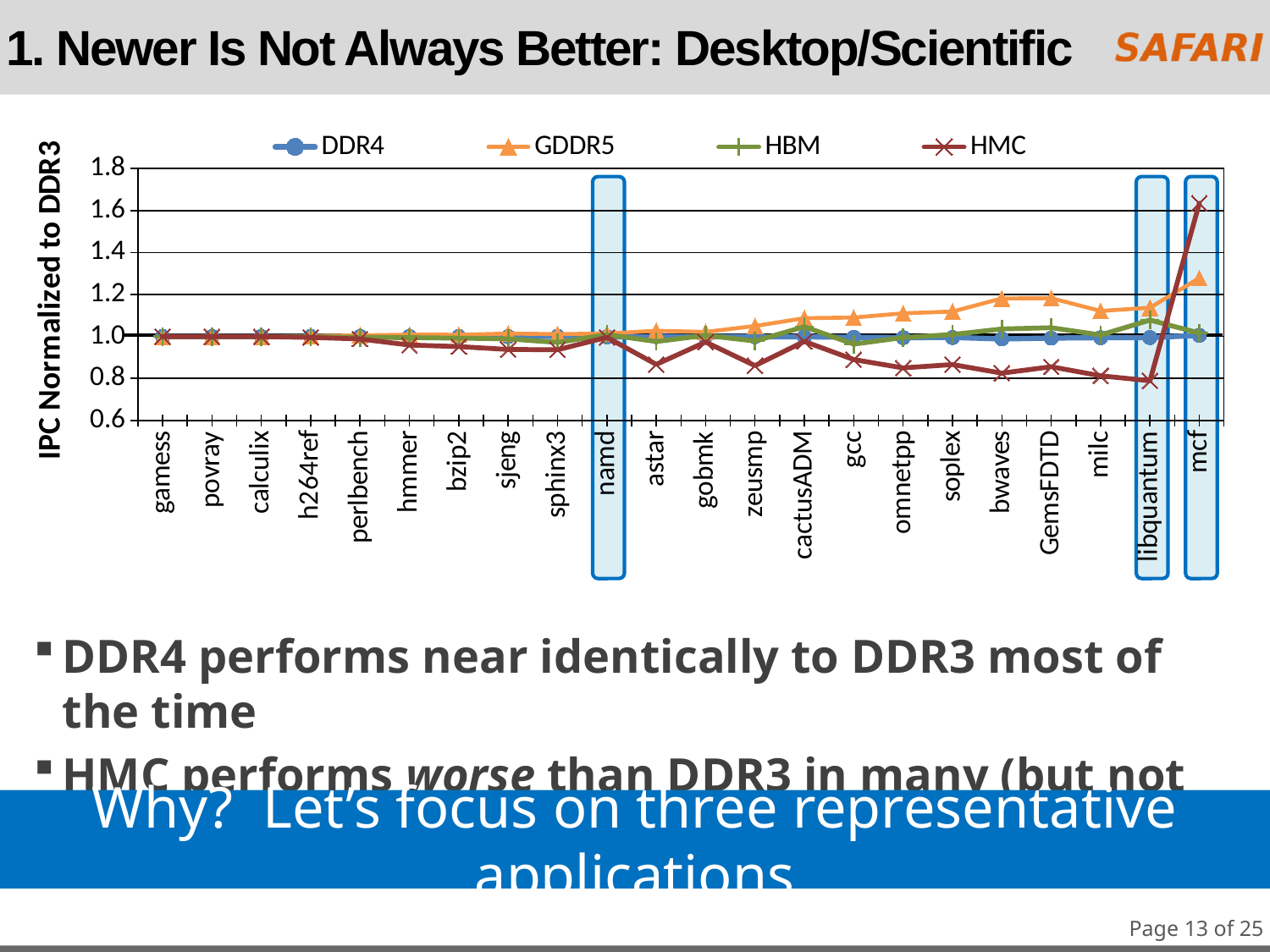
For which application does the HMC series reach its highest value? mcf Which three applications are highlighted with boxes on the chart? namd, libquantum, mcf For which application does the GDDR5 series reach its highest value? mcf Is the GDDR5 value for bwaves greater or less than 1.0? greater What is the title of the chart's y axis? IPC Normalized to DDR3 How many series does the chart's legend list? 4 Is the HMC value for astar greater or less than 1.0? less Is the HMC value for mcf greater or less than 1.4? greater How many applications are plotted along the x axis of the chart? 22 For mcf, which series has the larger value, HMC or GDDR5? HMC For omnetpp, which series has the larger value, DDR4 or HMC? DDR4 What kind of chart is shown on the slide? line chart